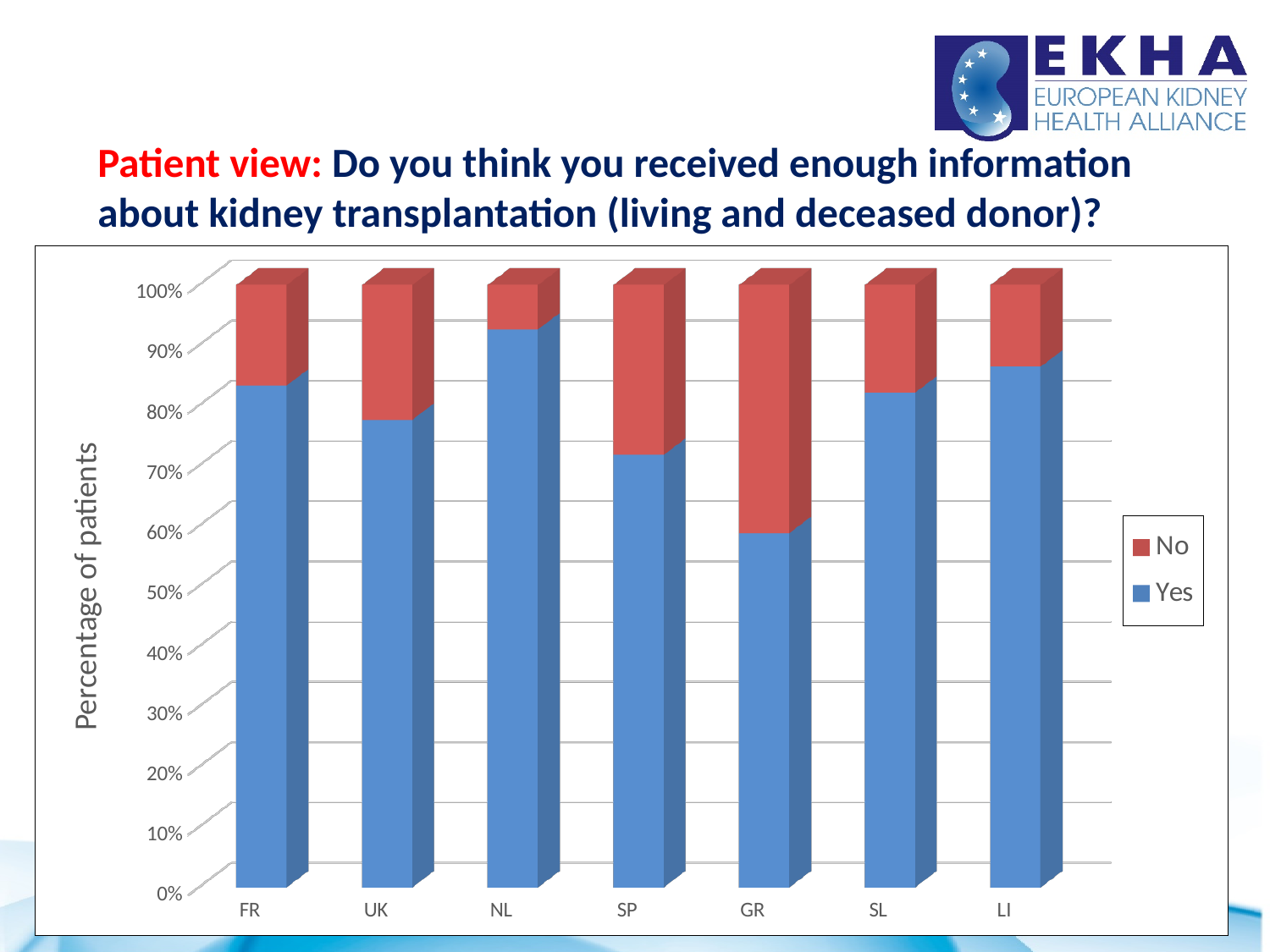
What colour represents the No series in the legend? red Which country has the largest share of patients answering No? GR Is the Yes share for GR greater or less than 70%? less What kind of chart is shown on the slide? stacked bar chart Which has a larger Yes share, LI or UK? LI Which country has the highest share of patients answering Yes? NL What is the total height of each stacked bar in the chart? 100% How many series does the legend list? 2 Which country has the lowest share of patients answering Yes? GR Is the Yes share for SP greater or less than 80%? less How many countries are shown on the x axis of the chart? 7 Is the Yes share for NL greater or less than 90%? greater